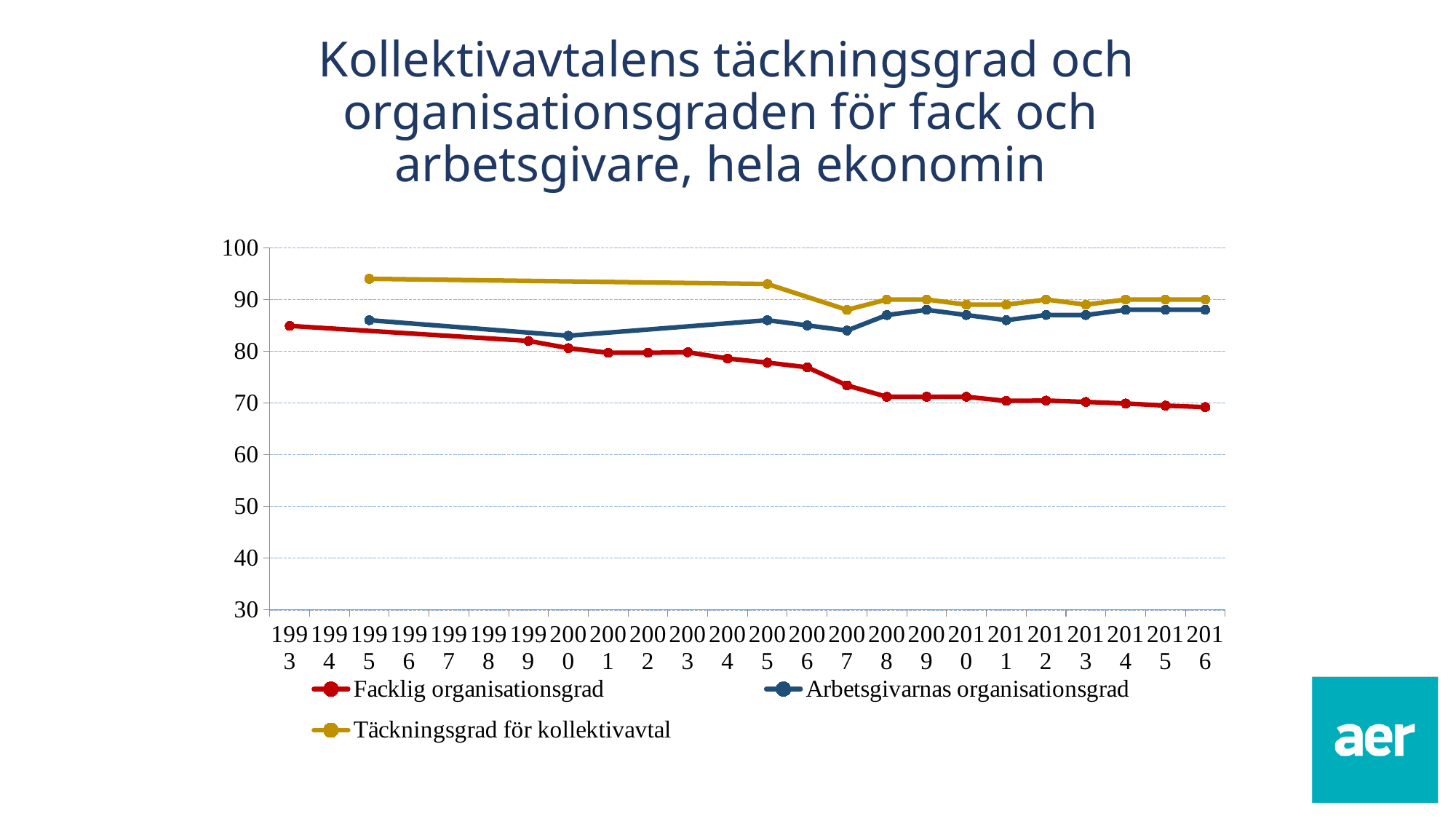
Is the value for Arbetsgivarnas organisationsgrad in 2000 greater or less than 80? greater In which year is Facklig organisationsgrad at its highest? 1993 Is the value for Täckningsgrad för kollektivavtal in 1995 greater or less than 90? greater Does the Facklig organisationsgrad series rise or fall from 1993 to 2016? fall What colour is the line for Täckningsgrad för kollektivavtal? yellow Is the value for Facklig organisationsgrad in 1993 greater or less than 80? greater What kind of chart is shown on the slide? line chart In 2016, which is larger: Täckningsgrad för kollektivavtal or Facklig organisationsgrad? Täckningsgrad för kollektivavtal How many series does the legend list? 3 In 2010, which is larger: Arbetsgivarnas organisationsgrad or Facklig organisationsgrad? Arbetsgivarnas organisationsgrad How many years are shown on the x axis? 24